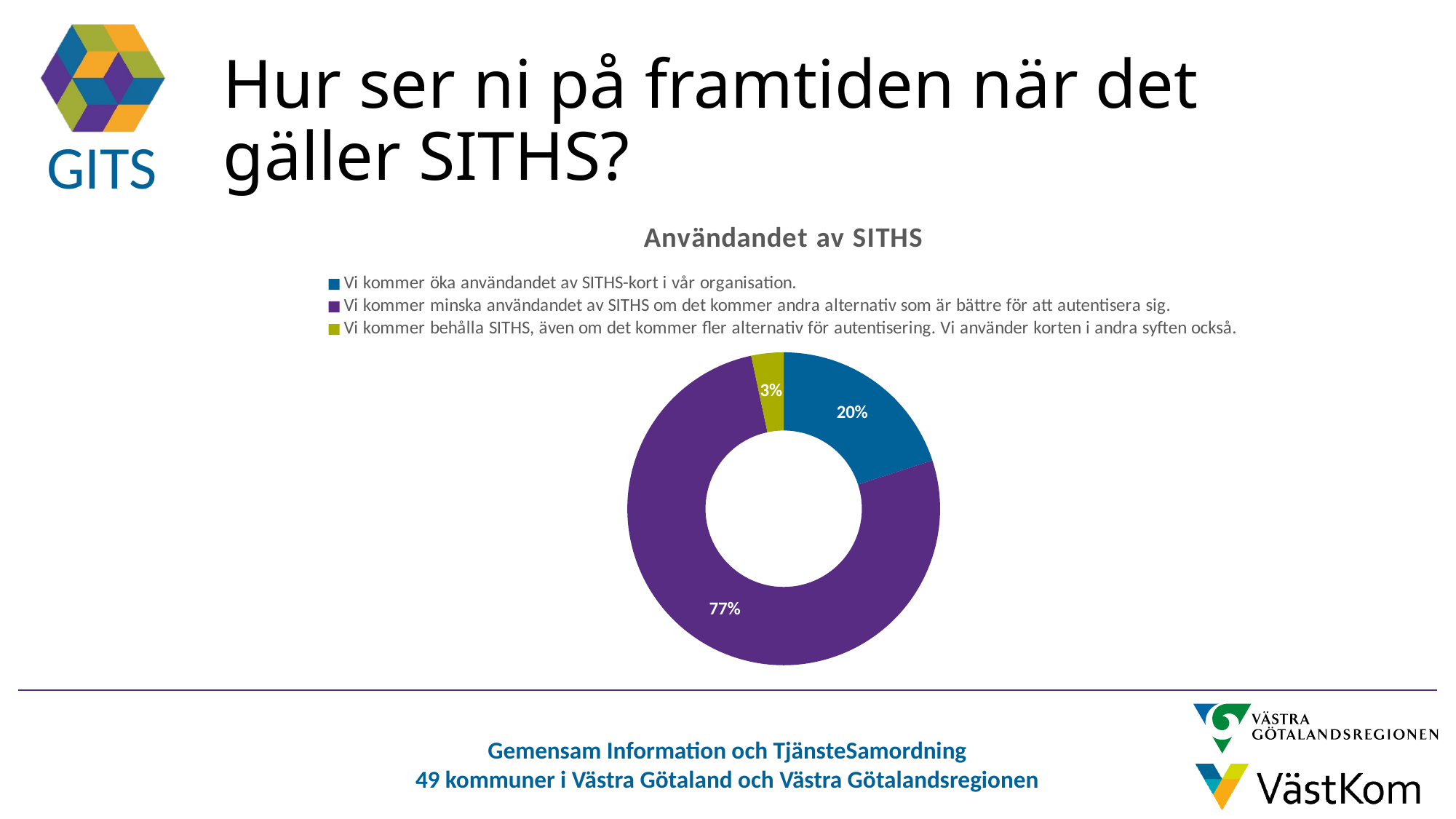
How many categories does the chart show? 3 What share of the chart is 'Vi kommer behålla SITHS, även om det kommer fler alternativ för autentisering. Vi använder korten i andra syften också.'? 3% What share of the chart is 'Vi kommer minska användandet av SITHS om det kommer andra alternativ som är bättre för att autentisera sig.'? 77% Which is larger: the share for 'Vi kommer öka användandet av SITHS-kort i vår organisation.' or the share for 'Vi kommer behålla SITHS...'? Vi kommer öka användandet av SITHS-kort i vår organisation. What is the title of the chart? Användandet av SITHS What share of the chart is 'Vi kommer öka användandet av SITHS-kort i vår organisation.'? 20% What colour is the slice representing 'Vi kommer minska användandet av SITHS...'? Purple What is the difference in percentage points between the 'minska' slice (77%) and the 'öka' slice (20%)? 57 percentage points How many entries does the legend list? 3 Which category has the largest share of the chart? Vi kommer minska användandet av SITHS om det kommer andra alternativ som är bättre för att autentisera sig. Which category has the smallest share of the chart? Vi kommer behålla SITHS, även om det kommer fler alternativ för autentisering. Vi använder korten i andra syften också. What kind of chart is shown on the slide? Doughnut (pie) chart